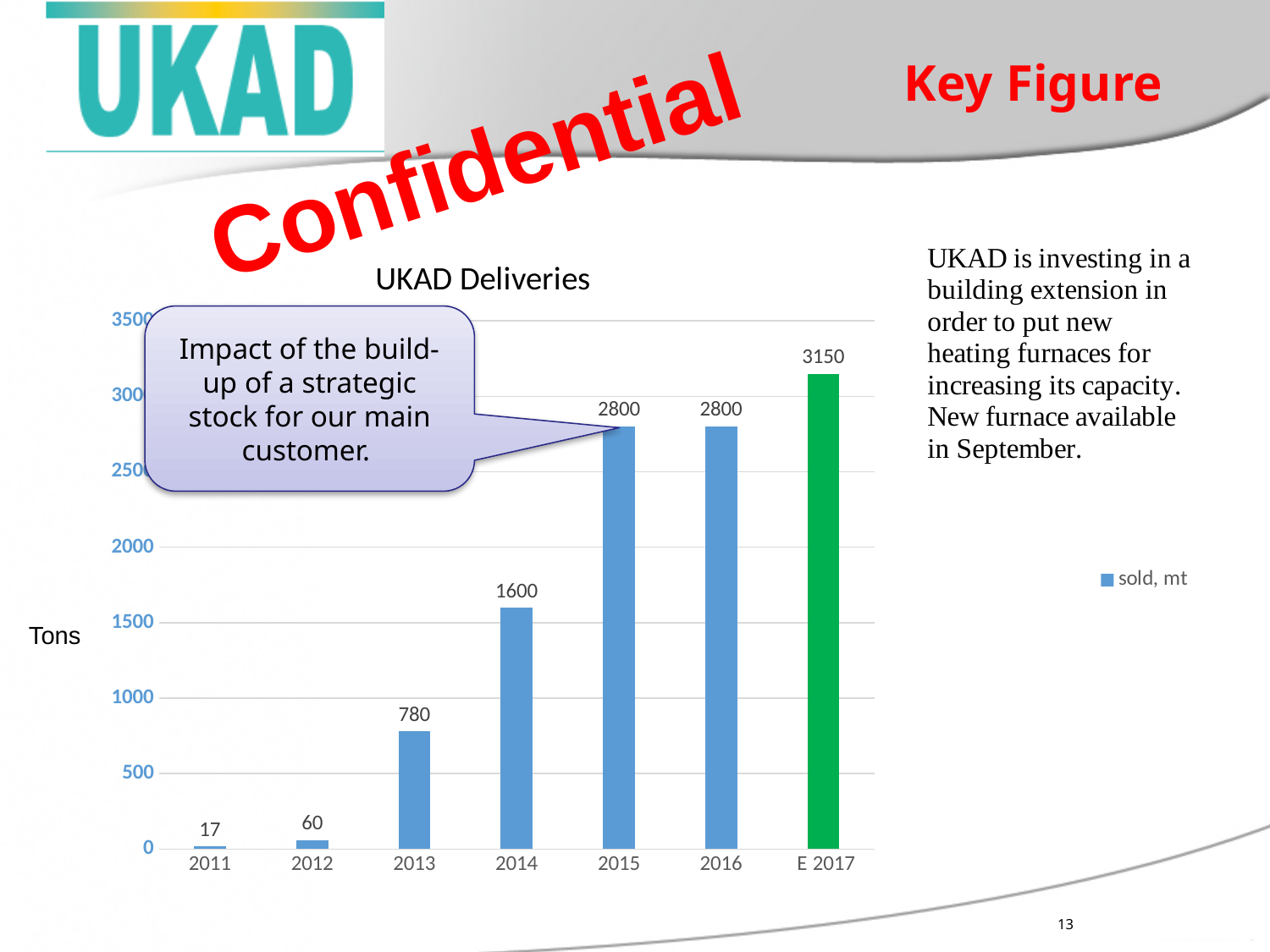
How many series does the legend of the UKAD Deliveries chart list? 1 What is the difference between the values for 2015 and 2014 in the UKAD Deliveries chart? 1200 What is the value for 2013 in the UKAD Deliveries chart? 780 What is the value for 2014 in the UKAD Deliveries chart? 1600 What kind of chart is the UKAD Deliveries chart? bar chart Do the values in the UKAD Deliveries chart generally rise or fall from 2011 to E 2017? rise What is the legend entry in the UKAD Deliveries chart? sold, mt Which category has the lowest value in the UKAD Deliveries chart? 2011 Which category has the highest value in the UKAD Deliveries chart? E 2017 Which is larger in the UKAD Deliveries chart, the value for 2012 or the value for 2013? 2013 What is the value for E 2017 in the UKAD Deliveries chart? 3150 How many categories are shown on the x axis of the UKAD Deliveries chart? 7